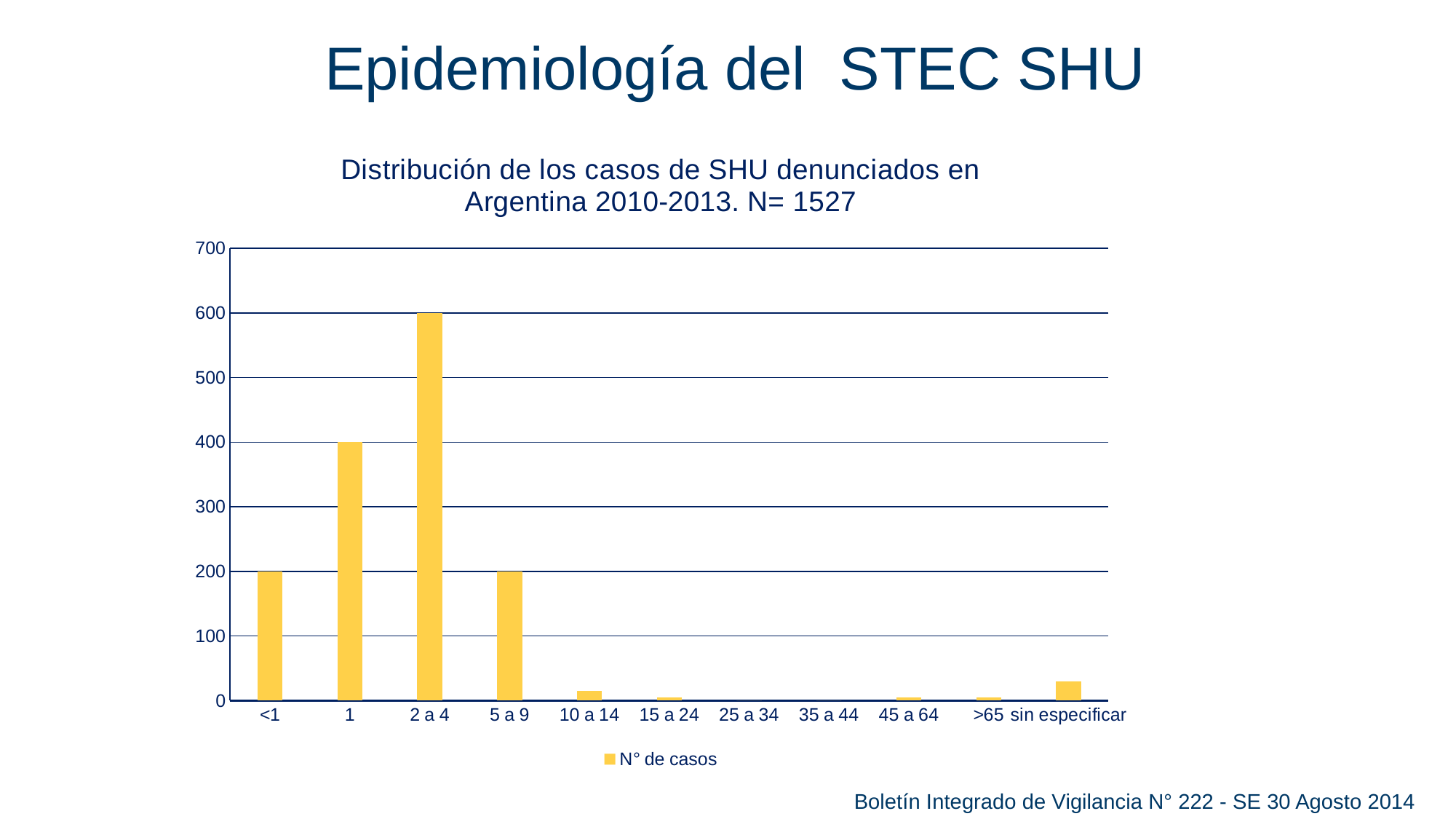
What is the name of the series shown in the legend? N° de casos What is the value for the '<1' age group? 200 What is the value for the '1' age group? 400 What is the difference between the values for '2 a 4' and '1'? 200 Which is larger, the value for '5 a 9' or the value for '1'? 1 Is the value for '10 a 14' greater or less than 100? less What kind of chart is shown on the slide? bar chart How many age-group categories are shown on the x axis? 11 Which age group has the highest number of cases? 2 a 4 What is the value for the '2 a 4' age group? 600 Is the value for 'sin especificar' greater or less than 100? less How many series does the legend list? 1